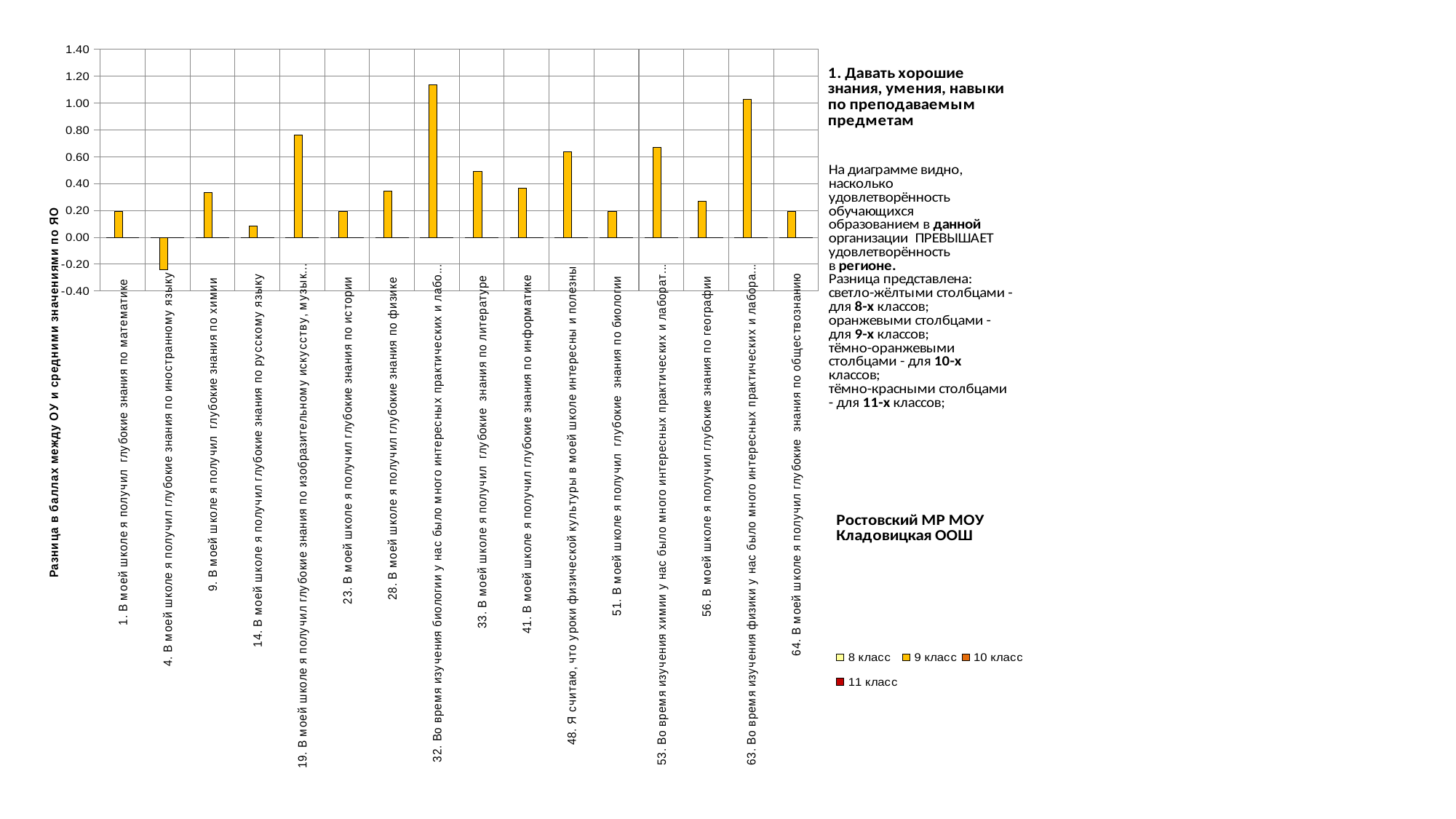
How many series does the legend list? 4 How many categories (statements) are plotted along the x axis? 16 Is the value for statement 14 (глубокие знания по русскому языку) greater or less than 0.20? less Which statement has the lowest bar? 4. В моей школе я получил глубокие знания по иностранному языку Is the value for statement 19 (глубокие знания по изобразительному искусству, музыке) greater or less than 0.60? greater Which is larger: the value for statement 19 (изобразительное искусство, музыка) or statement 9 (глубокие знания по химии)? 19. В моей школе я получил глубокие знания по изобразительному искусству, музык... Which is larger: the value for statement 48 (уроки физической культуры интересны и полезны) or statement 56 (глубокие знания по географии)? 48. Я считаю, что уроки физической культуры в моей школе интересны и полезны Is the value for statement 32 (изучение биологии, практические и лабораторные) greater or less than 1.00? greater What colour does the legend use for the series '11 класс'? dark red What kind of chart is shown on the slide? bar chart Which statement has the highest bar? 32. Во время изучения биологии у нас было много интересных практических и лабо...